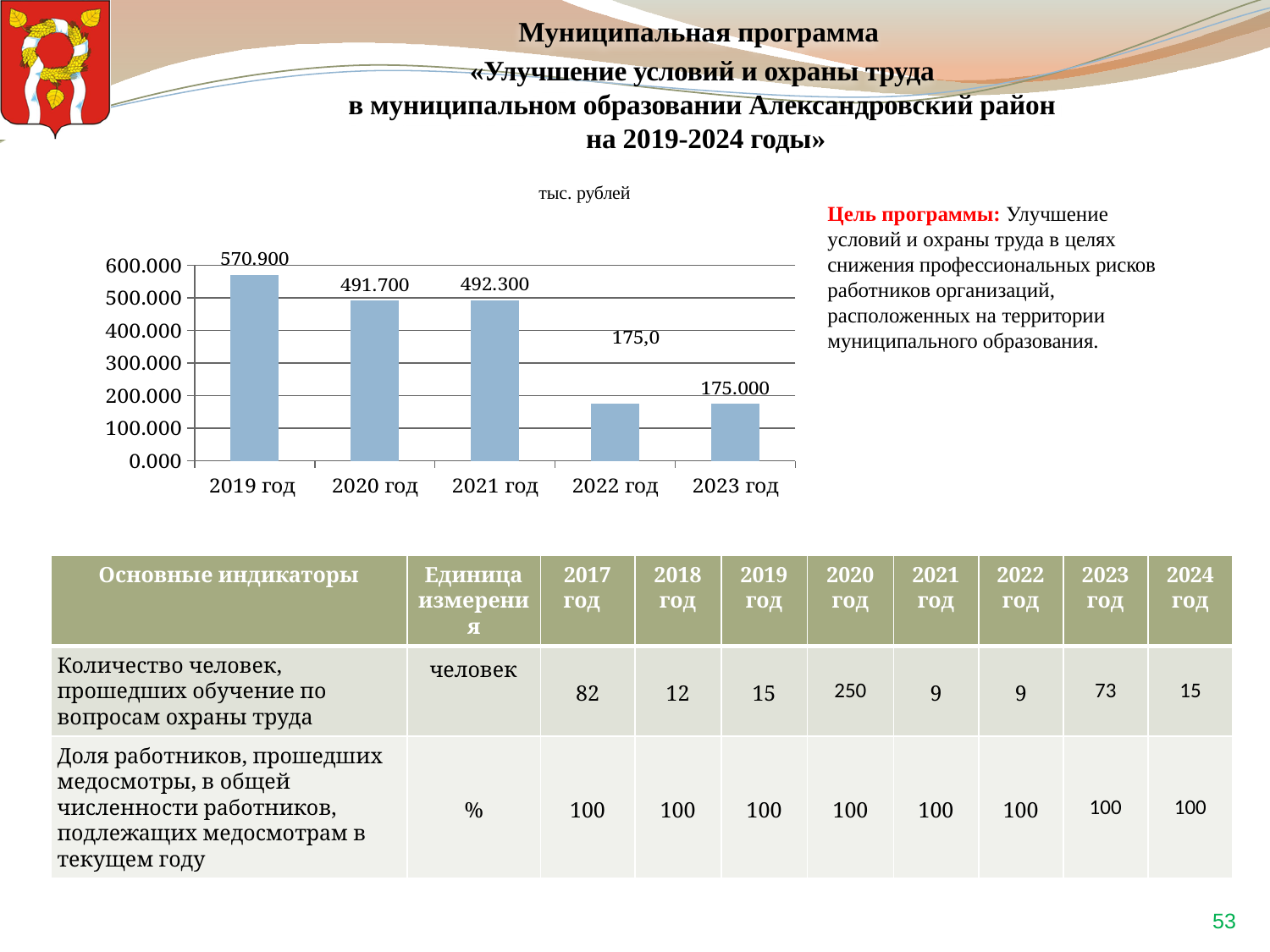
What type of chart is shown on the slide? bar chart Which year has the highest value in the bar chart? 2019 год What is the value shown for 2023 год in the bar chart? 175.000 How many years (categories) are plotted in the bar chart? 5 What is the difference between the values for 2019 год and 2020 год in the bar chart? 79.200 Which is larger in the bar chart, the value for 2019 год or the value for 2022 год? 2019 год Is the value for 2022 год greater or less than 200.000? less What unit is indicated above the bar chart? тыс. рублей What is the value shown for 2019 год in the bar chart? 570.900 What is the value shown for 2021 год in the bar chart? 492.300 Do the values in the bar chart generally rise or fall from 2019 год to 2023 год? fall What is the value shown for 2020 год in the bar chart? 491.700